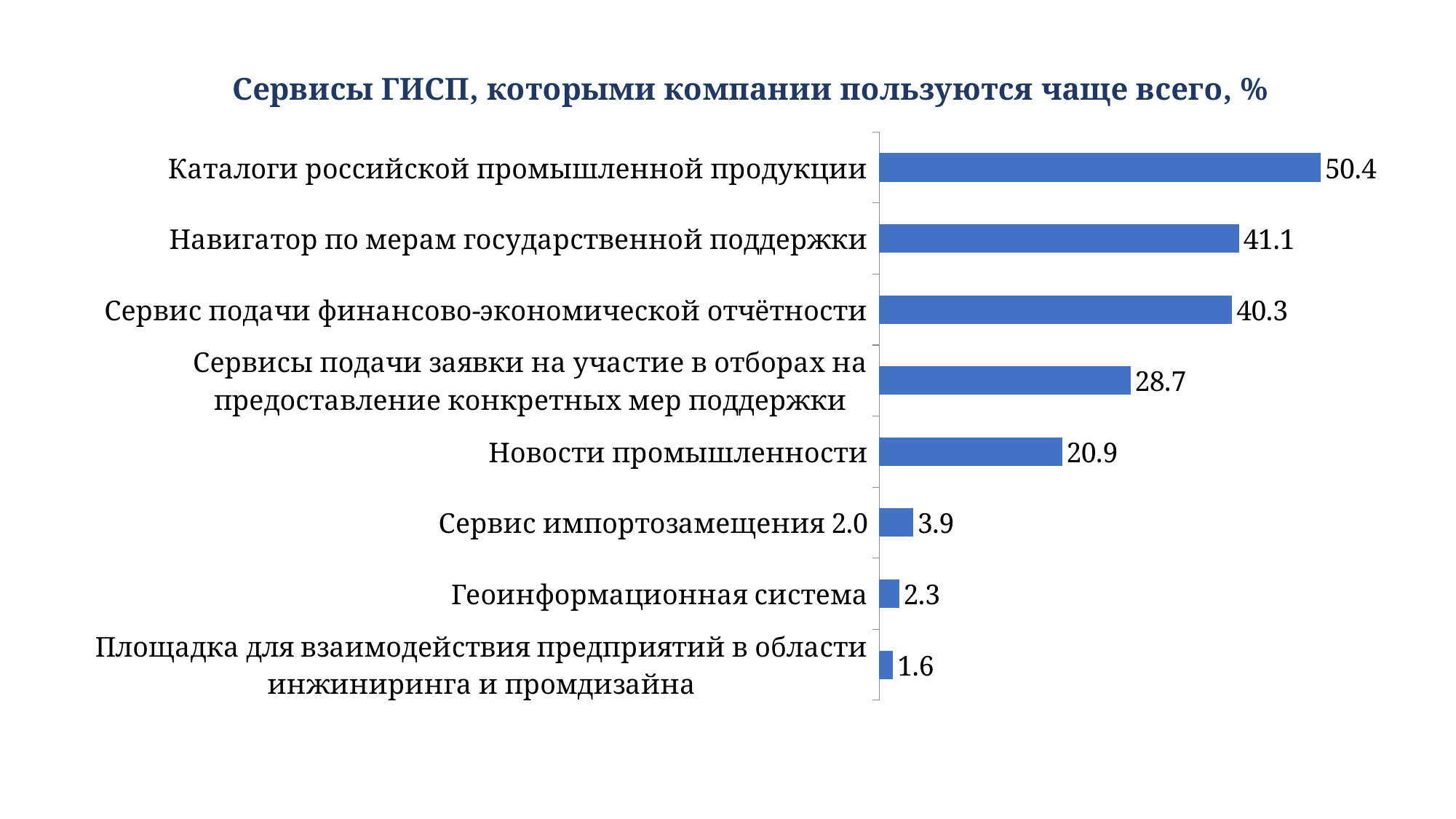
What is the difference between the values for Каталоги российской промышленной продукции and Новости промышленности? 29.5 What is the value for Каталоги российской промышленной продукции? 50.4 Which category has the lowest value? Площадка для взаимодействия предприятий в области инжиниринга и промдизайна What kind of chart is this? bar chart What is the value for Геоинформационная система? 2.3 How many categories are shown in the chart? 8 What is the title of the chart? Сервисы ГИСП, которыми компании пользуются чаще всего, % Which category has the highest value? Каталоги российской промышленной продукции Which is larger: the value for Сервис импортозамещения 2.0 or the value for Геоинформационная система? Сервис импортозамещения 2.0 What is the value for Сервисы подачи заявки на участие в отборах на предоставление конкретных мер поддержки? 28.7 What is the difference between the values for Навигатор по мерам государственной поддержки and Сервис подачи финансово-экономической отчётности? 0.8 What is the value for Новости промышленности? 20.9